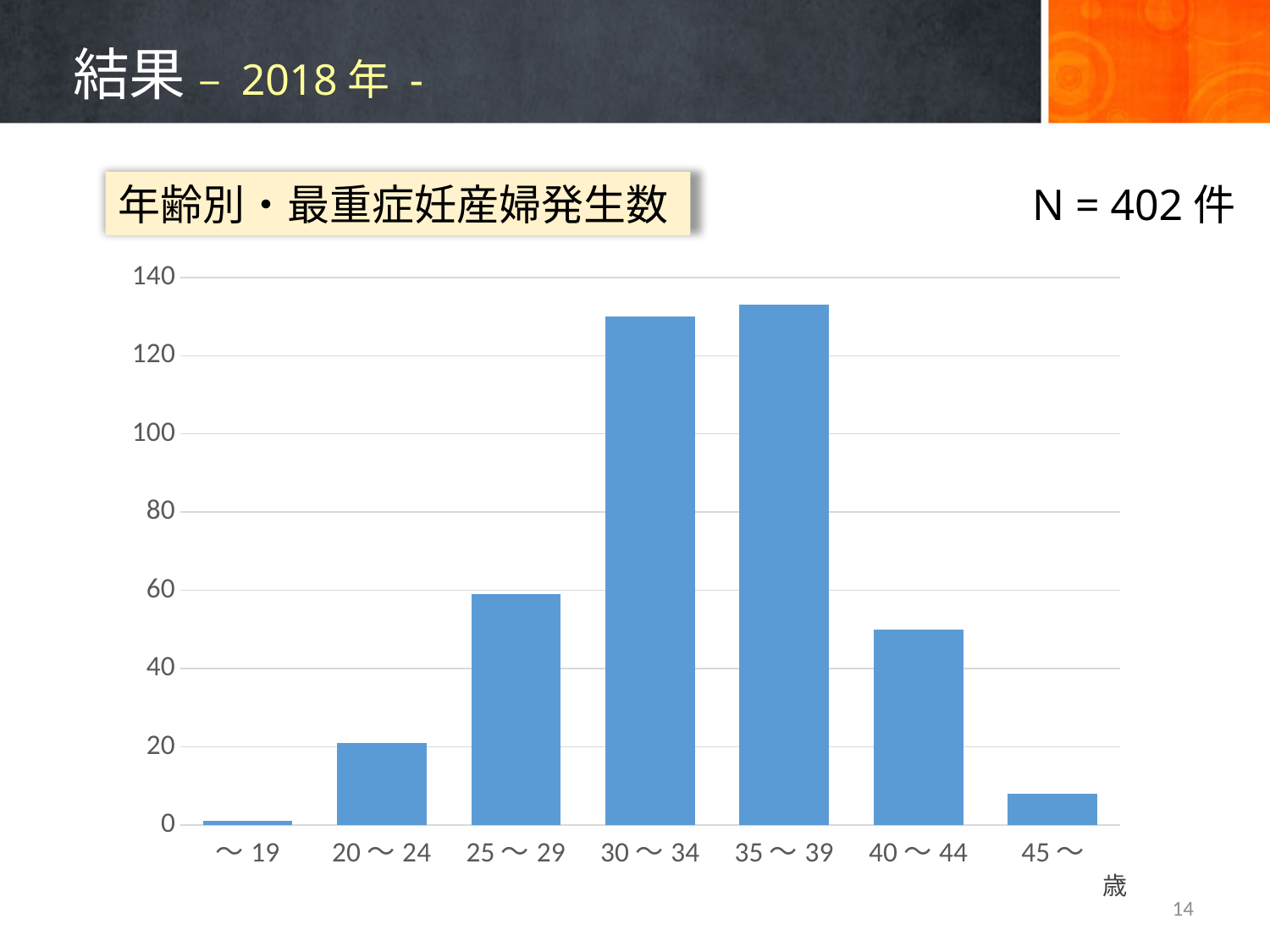
Which age category has the highest value? 35～39 What total N is stated next to the chart? N = 402 件 How many age categories are shown on the x axis? 7 What is the title of the chart? 年齢別・最重症妊産婦発生数 Is the value for 40～44 greater or less than 60? less Is the value for 45～ greater or less than 20? less Which is larger, the value for 25～29 or the value for 40～44? 25～29 What kind of chart is shown on the slide? bar chart Is the value for 30～34 greater or less than 120? greater Which age category has the lowest value? ～19